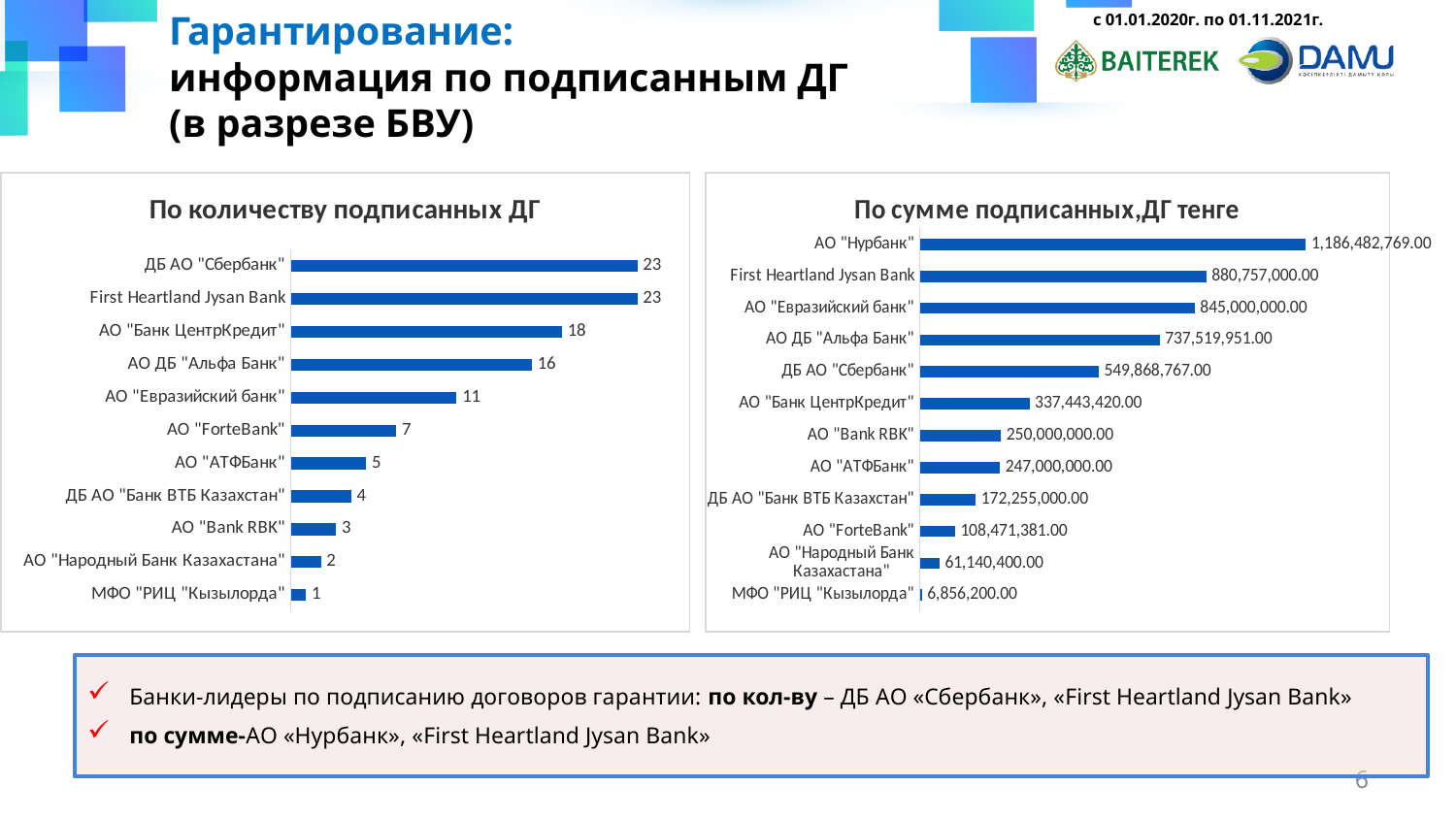
In the chart "По сумме подписанных,ДГ тенге", which category has the highest value? АО "Нурбанк" In the chart "По сумме подписанных,ДГ тенге", what is the value for АО "Евразийский банк"? 845,000,000.00 In the chart "По количеству подписанных ДГ", how many categories are shown? 11 In the chart "По количеству подписанных ДГ", what is the value for АО "ForteBank"? 7 In the chart "По сумме подписанных,ДГ тенге", what is the value for МФО "РИЦ "Кызылорда"? 6,856,200.00 In the chart "По количеству подписанных ДГ", what is the value for АО "Банк ЦентрКредит"? 18 In the chart "По количеству подписанных ДГ", what is the difference between АО ДБ "Альфа Банк" and АО "Евразийский банк"? 5 In the chart "По сумме подписанных,ДГ тенге", what is the value for ДБ АО "Сбербанк"? 549,868,767.00 What type of chart is "По сумме подписанных,ДГ тенге"? Bar chart In the chart "По количеству подписанных ДГ", which category has the lowest value? МФО "РИЦ "Кызылорда" In the chart "По сумме подписанных,ДГ тенге", which is larger: АО "Bank RBK" or ДБ АО "Банк ВТБ Казахстан"? АО "Bank RBK" In the chart "По сумме подписанных,ДГ тенге", how many categories are shown? 12